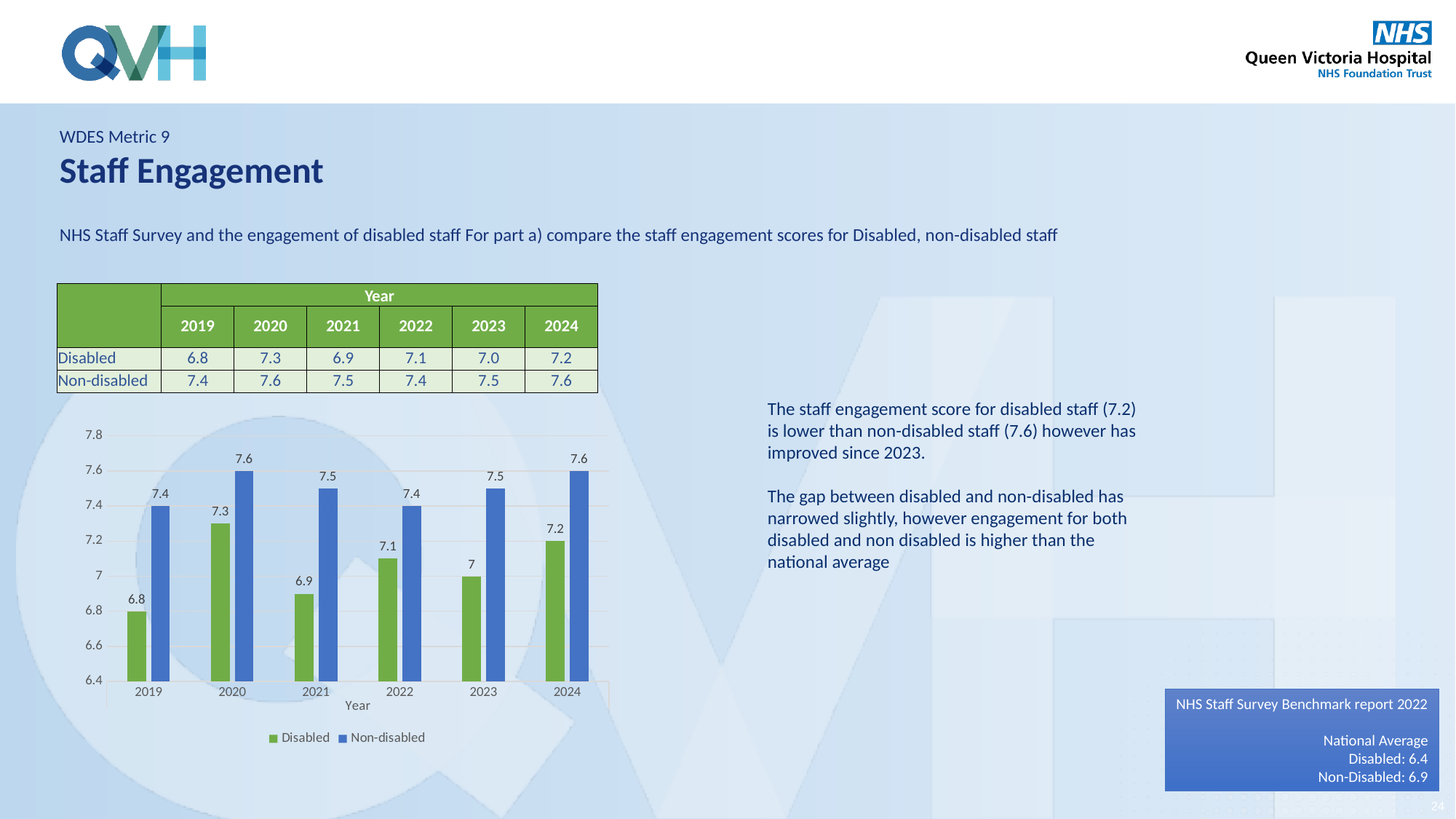
How many series does the chart legend list? 2 Which is larger in 2021, the Disabled score or the Non-disabled score? Non-disabled What kind of chart is shown on the slide? Bar chart What colour are the Non-disabled bars in the chart? Blue In which year is the Disabled score highest? 2020 What is the Disabled staff engagement score for 2023? 7 What is the difference between the Non-disabled and Disabled scores in 2024? 0.4 Did the Disabled score rise or fall from 2023 to 2024? Rise How many years are shown on the x axis of the chart? 6 What is the Disabled staff engagement score for 2019? 6.8 In which year is the Disabled score lowest? 2019 What is the Non-disabled staff engagement score for 2022? 7.4